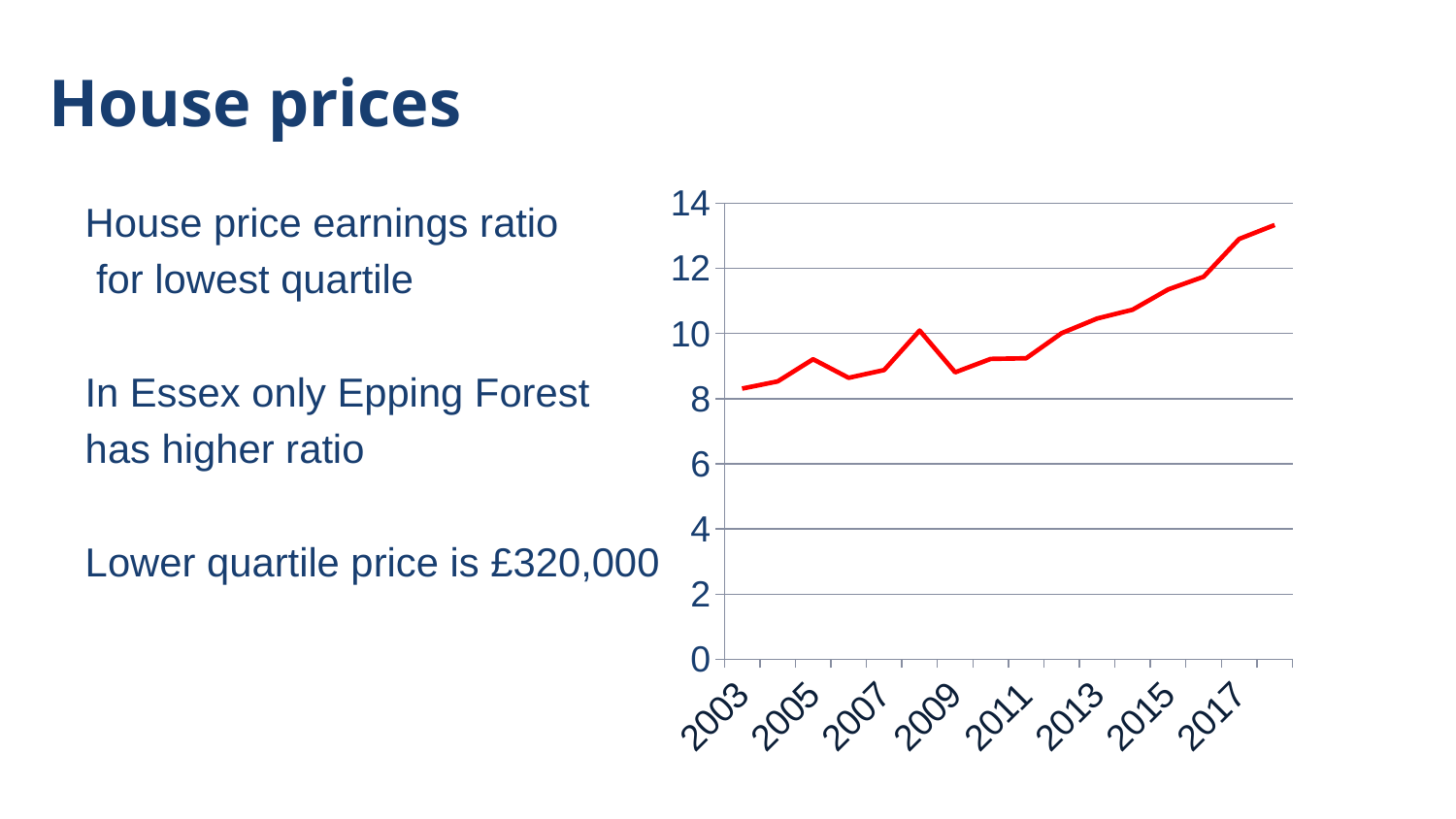
Which is larger, the value for 2017 or the value for 2003? 2017 Which is larger, the value for 2013 or the value for 2009? 2013 Is the value for 2003 greater or less than 8? greater What kind of chart is shown on the slide? line chart Is the value for 2017 greater or less than 12? greater Is the value for 2009 greater or less than 10? less Do the values in the chart generally rise or fall from 2003 to the end of the series? rise Which labelled year on the x axis has the lowest value in the chart? 2003 What colour is the line in the chart? red How many year labels are printed on the x axis of the chart? 8